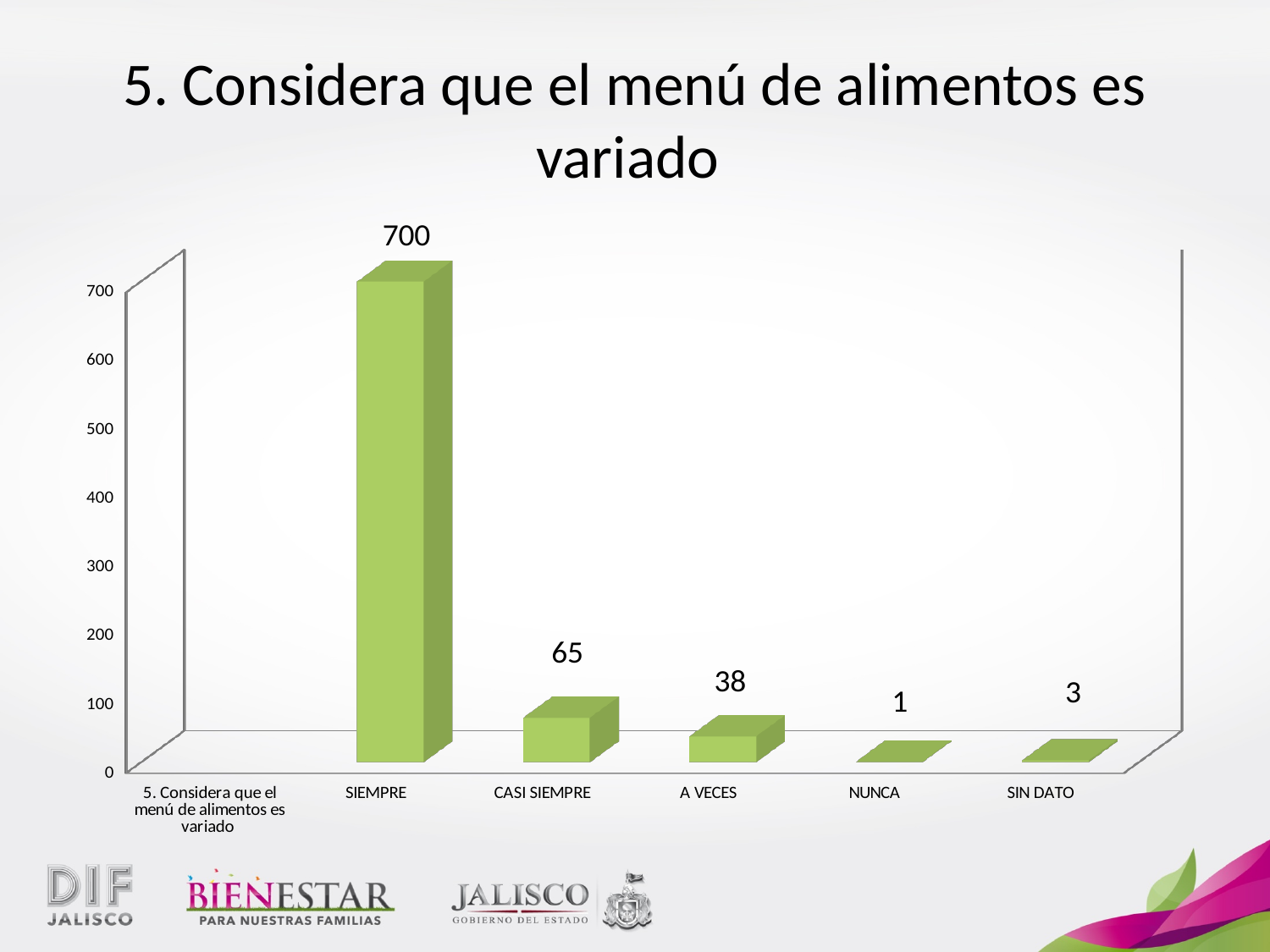
What is the title of the slide? 5. Considera que el menú de alimentos es variado What is the difference between the values for SIEMPRE and CASI SIEMPRE? 635 What is the value for SIEMPRE? 700 What kind of chart is shown on the slide? Bar chart What is the value for A VECES? 38 What is the value for NUNCA? 1 What is the value for SIN DATO? 3 Which is larger, the value for A VECES or the value for SIN DATO? A VECES Which category has the lowest value? NUNCA Which category has the highest value? SIEMPRE What is the value for CASI SIEMPRE? 65 How many bars are plotted in the chart? 5